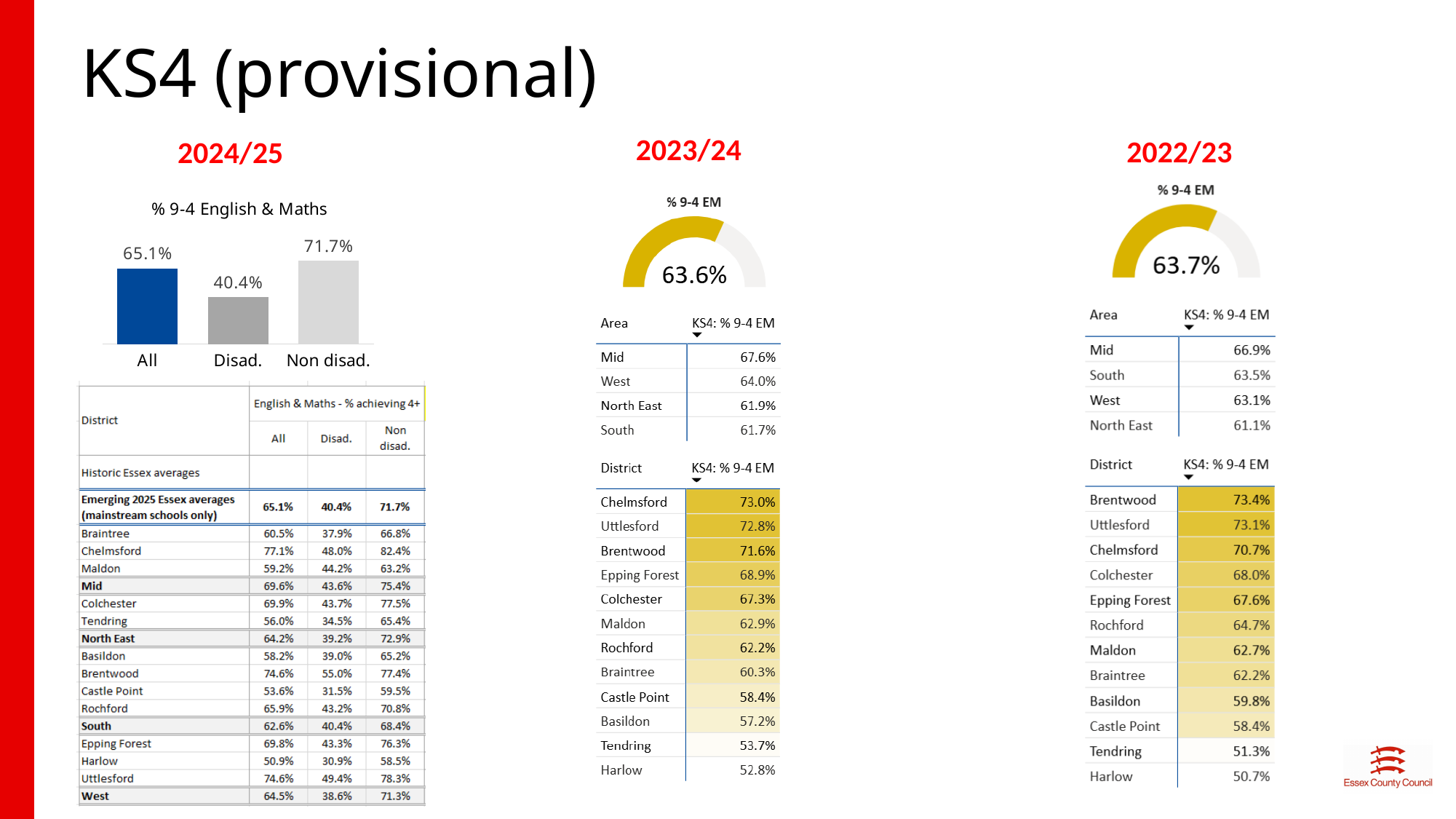
In the 2024/25 '% 9-4 English & Maths' bar chart, which is larger, the value for All or the value for Disad.? All What value does the 2022/23 '% 9-4 EM' gauge chart show? 63.7% In the 2024/25 '% 9-4 English & Maths' bar chart, which category has the lowest value? Disad. What value does the 2023/24 '% 9-4 EM' gauge chart show? 63.6% In the 2024/25 '% 9-4 English & Maths' bar chart, what is the difference between the Non disad. and Disad. values? 31.3% In the 2024/25 '% 9-4 English & Maths' bar chart, what is the value for Non disad.? 71.7% In the 2024/25 '% 9-4 English & Maths' bar chart, which category has the highest value? Non disad. What kind of chart is the 2024/25 '% 9-4 English & Maths' chart? Bar chart In the 2024/25 '% 9-4 English & Maths' bar chart, what is the value for Disad.? 40.4% In the 2024/25 '% 9-4 English & Maths' bar chart, what colour is the bar for All? Blue In the 2024/25 '% 9-4 English & Maths' bar chart, what is the value for All? 65.1% How many bars are in the 2024/25 '% 9-4 English & Maths' chart? 3